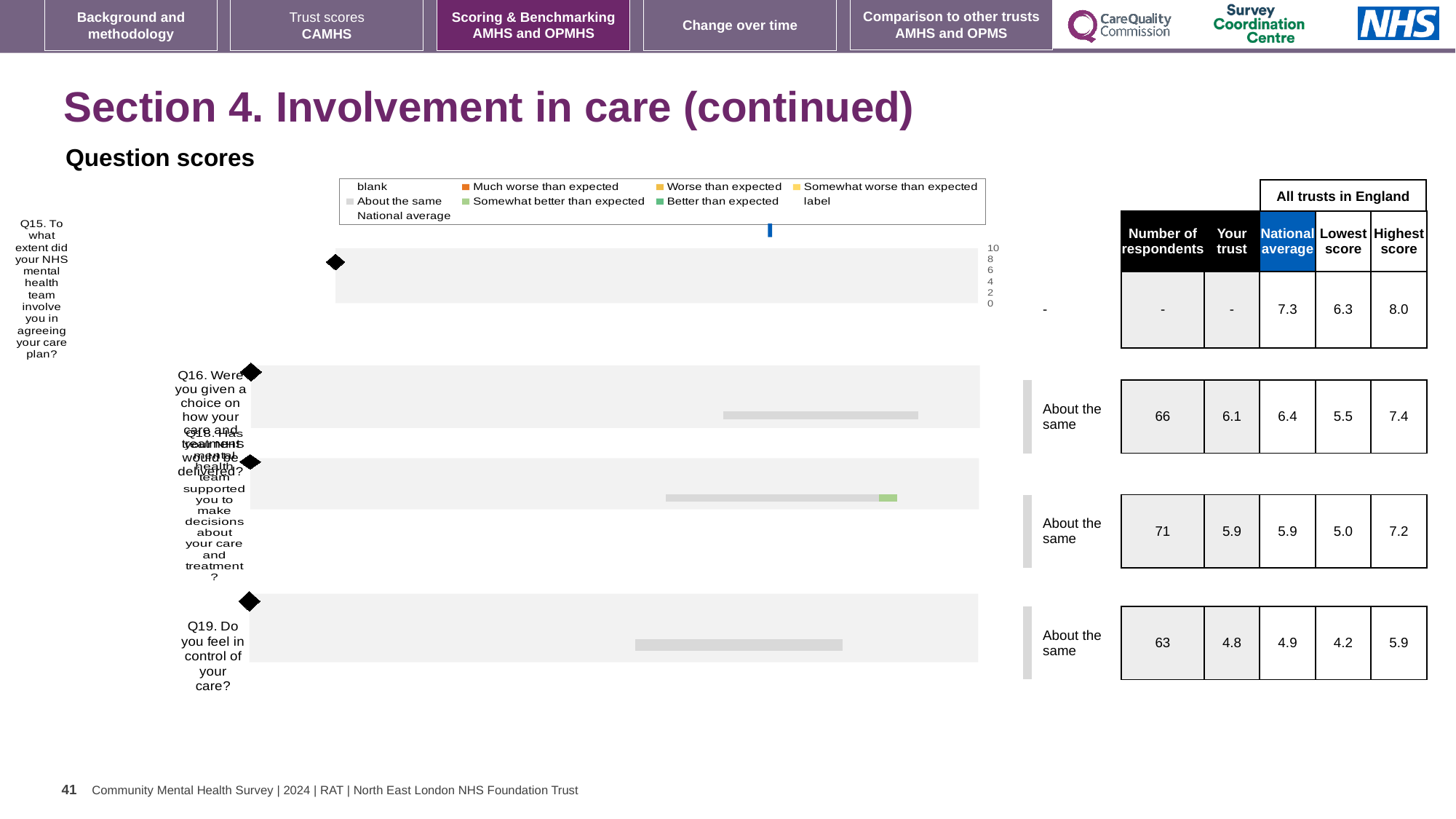
How many questions (categories) are plotted in the question scores chart? 4 What is the difference between the highest score and the lowest score for Q15 in the table beside the chart? 1.7 Which question has the highest 'Your trust' score in the table beside the chart? Q16 In the table beside the chart, what is the national average for Q19 (Do you feel in control of your care)? 4.9 In the table beside the chart, what is the 'Your trust' score for Q16 (Were you given a choice on how your care and treatment would be delivered)? 6.1 Which question has the lowest 'Your trust' score in the table beside the chart? Q19 For Q19, which is larger: the highest score across all trusts in England or the national average? Highest score What is the maximum value shown on the chart's axis? 10 What is the difference between the national average and the 'Your trust' score for Q16? 0.3 What kind of chart is used to show the question scores on this slide? bar chart How many entries does the legend of the question scores chart list? 9 In the table beside the chart, how many respondents answered Q18? 71